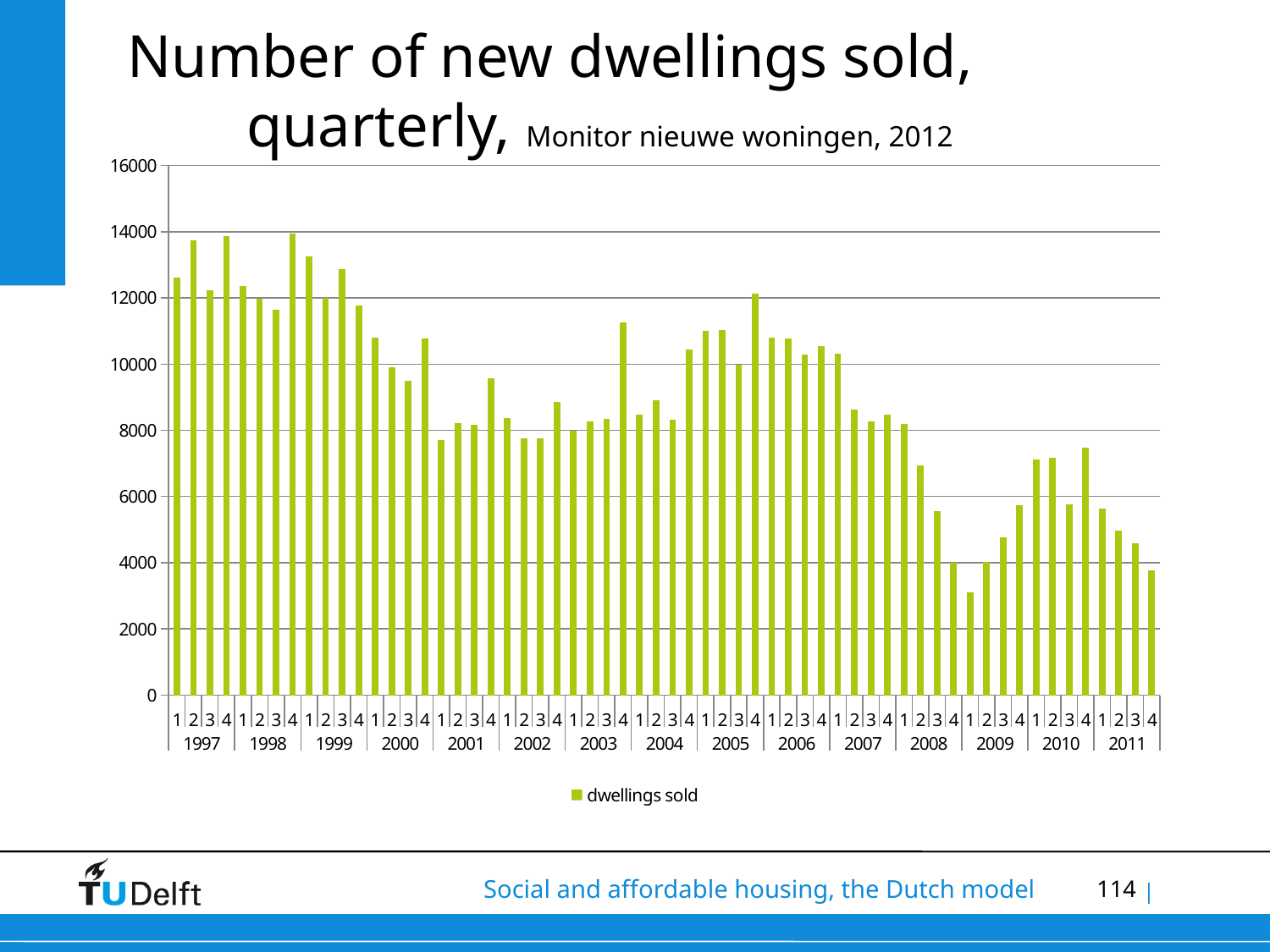
How many quarterly bars are plotted in total? 60 How many years are shown along the x axis? 15 What kind of chart is shown on the slide? bar chart Is the value for quarter 1 of 2009 greater or less than 4000? less Overall, do the values rise or fall from 1997 to 2011? fall Is the value for quarter 4 of 2011 greater or less than 4000? less Is the value for quarter 1 of 1997 greater or less than 12000? greater Which quarter has the lowest number of dwellings sold? 2009 quarter 1 Which is larger, the value for quarter 4 of 2005 or the value for quarter 1 of 2006? quarter 4 of 2005 What is the name of the series shown in the legend? dwellings sold How many series does the legend list? 1